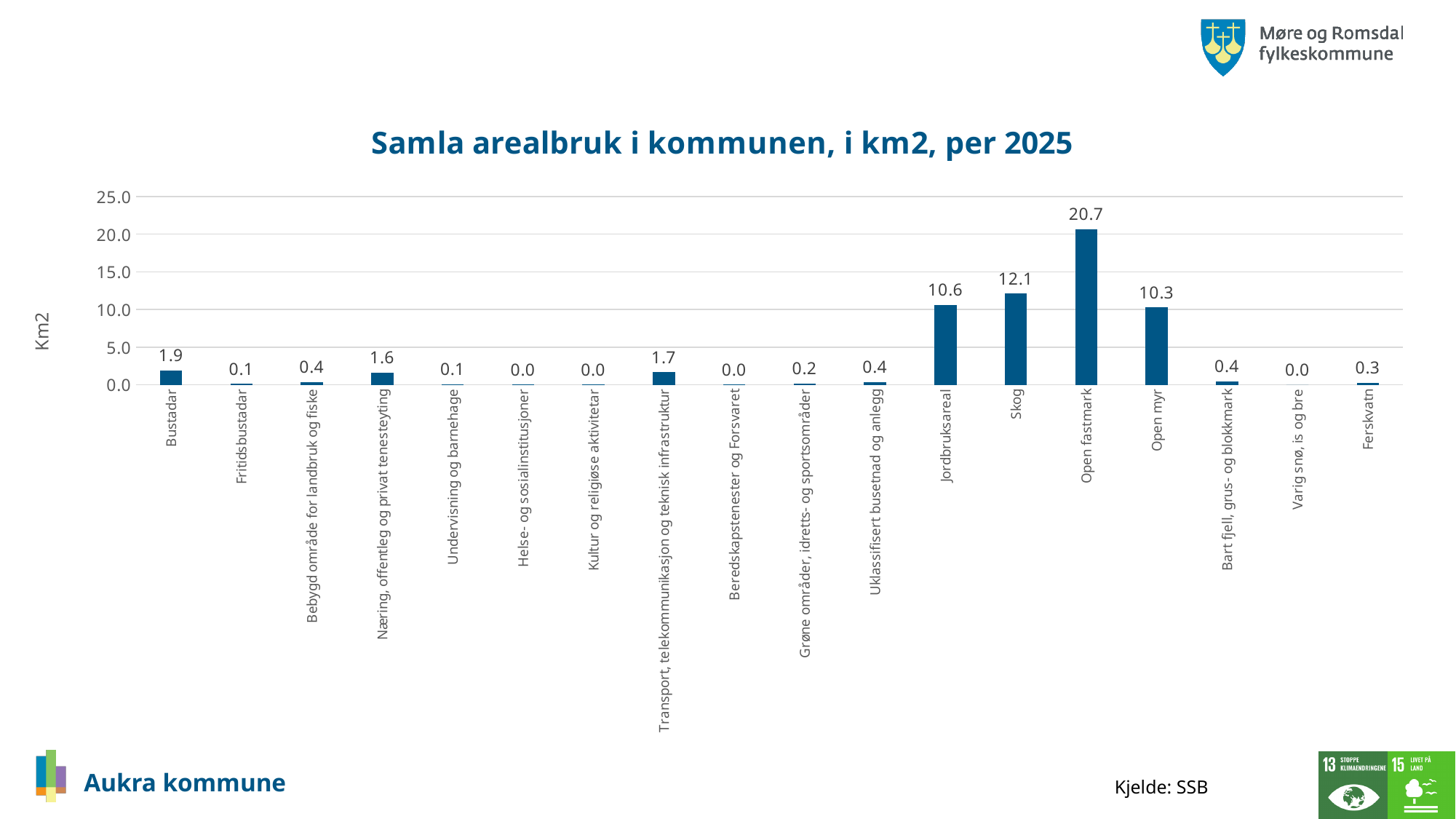
What is the difference between the values for Skog and Open myr? 1.8 What is the title of the chart? Samla arealbruk i kommunen, i km2, per 2025 How many categories are shown on the x axis? 18 What is the value for Open fastmark? 20.7 Which category has the highest value? Open fastmark What type of chart is shown on the slide? bar chart Which is larger, the value for Skog or the value for Jordbruksareal? Skog What is the label on the y axis? Km2 What is the value for Bustadar? 1.9 What is the value for Ferskvatn? 0.3 What is the value for Jordbruksareal? 10.6 Is the value for Open fastmark greater or less than 20.0? greater